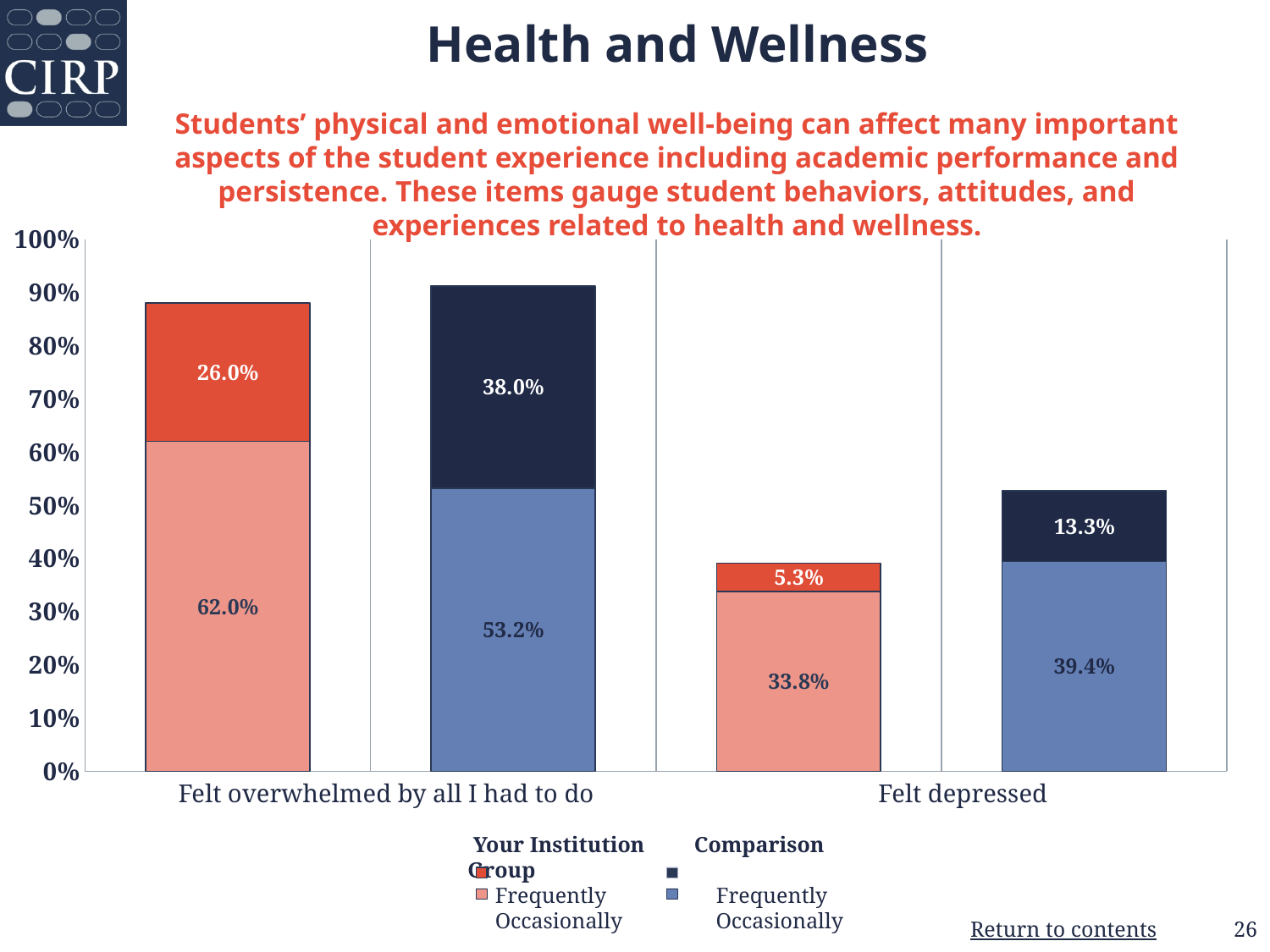
How many survey items (categories) are shown on the x axis of the chart? 2 Is the total stacked bar for the Comparison Group on 'Felt overwhelmed by all I had to do' greater or less than 90%? greater What is the total percentage (frequently plus occasionally) of Your Institution students who felt overwhelmed by all they had to do? 88.0% Which group has the larger percentage of students who occasionally felt depressed, Your Institution or the Comparison Group? Comparison Group What percentage of students at Your Institution reported frequently feeling overwhelmed by all they had to do? 26.0% What percentage of students at Your Institution reported frequently feeling depressed? 5.3% What is the total percentage (frequently plus occasionally) of the Comparison Group who felt depressed? 52.7% How many series does the chart legend list? 4 What percentage of the Comparison Group reported occasionally feeling depressed? 39.4% What is the difference between the Comparison Group and Your Institution in the percentage who frequently felt overwhelmed by all they had to do? 12.0% Which segment across the whole chart has the lowest value? Your Institution, Frequently, Felt depressed (5.3%) What type of chart is shown on the slide? Stacked bar chart